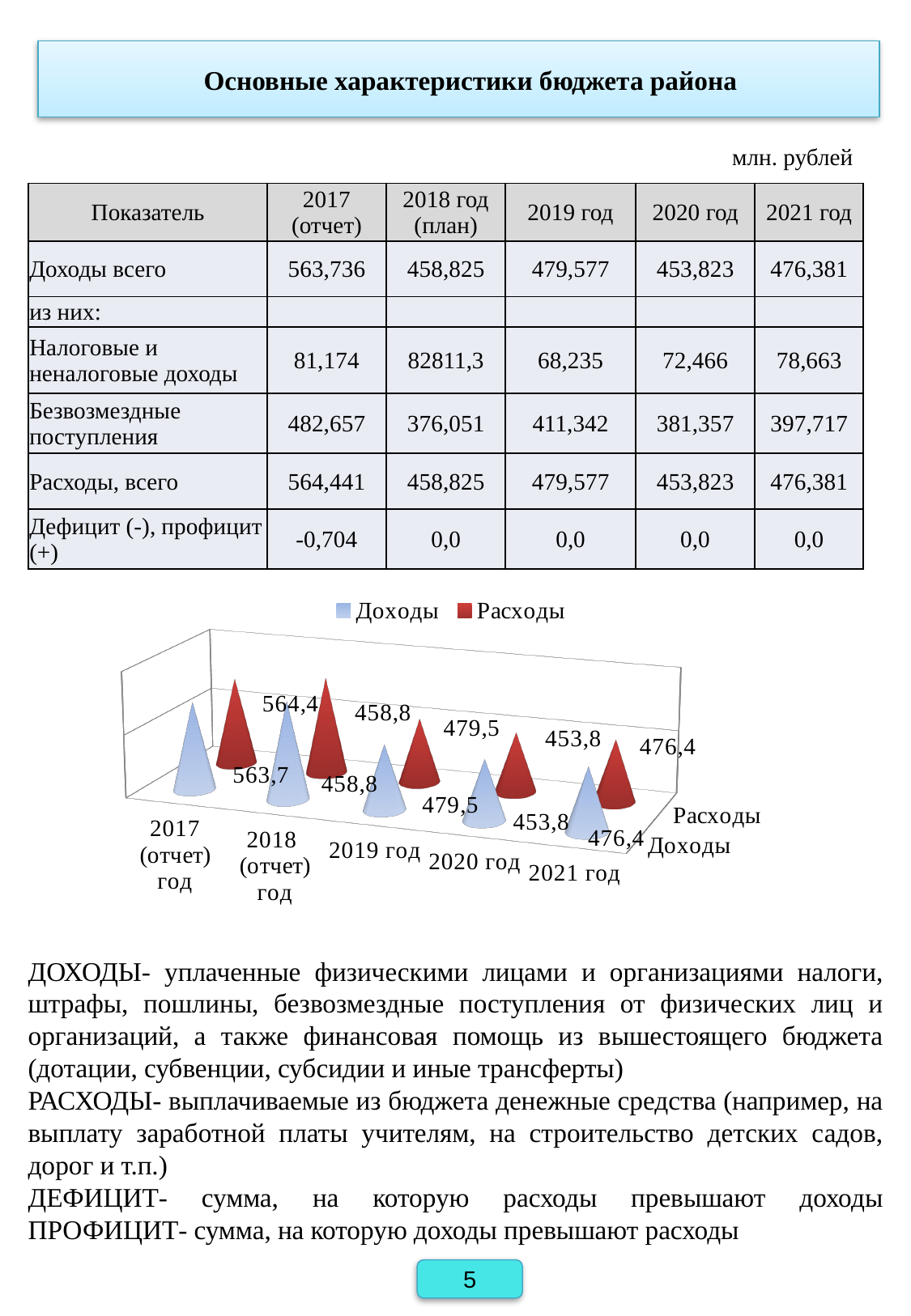
Which colour represents Расходы in the chart? red What is the value of Доходы for 2020 год in the chart? 453,8 What is the value of Расходы for 2017 (отчет) год in the chart? 564,4 What is the value of Доходы for 2017 (отчет) год in the chart? 563,7 What kind of chart is shown on the slide? bar chart Which year has the highest Доходы value in the chart? 2017 (отчет) год What is the value of Расходы for 2021 год in the chart? 476,4 Which year has the lowest Расходы value in the chart? 2020 год How many years are shown on the x axis of the chart? 5 What is the difference between the Доходы values for 2017 (отчет) год and 2018 (отчет) год in the chart? 104,9 How many series does the chart legend list? 2 Which is larger in the chart: Доходы for 2019 год or Доходы for 2020 год? 2019 год